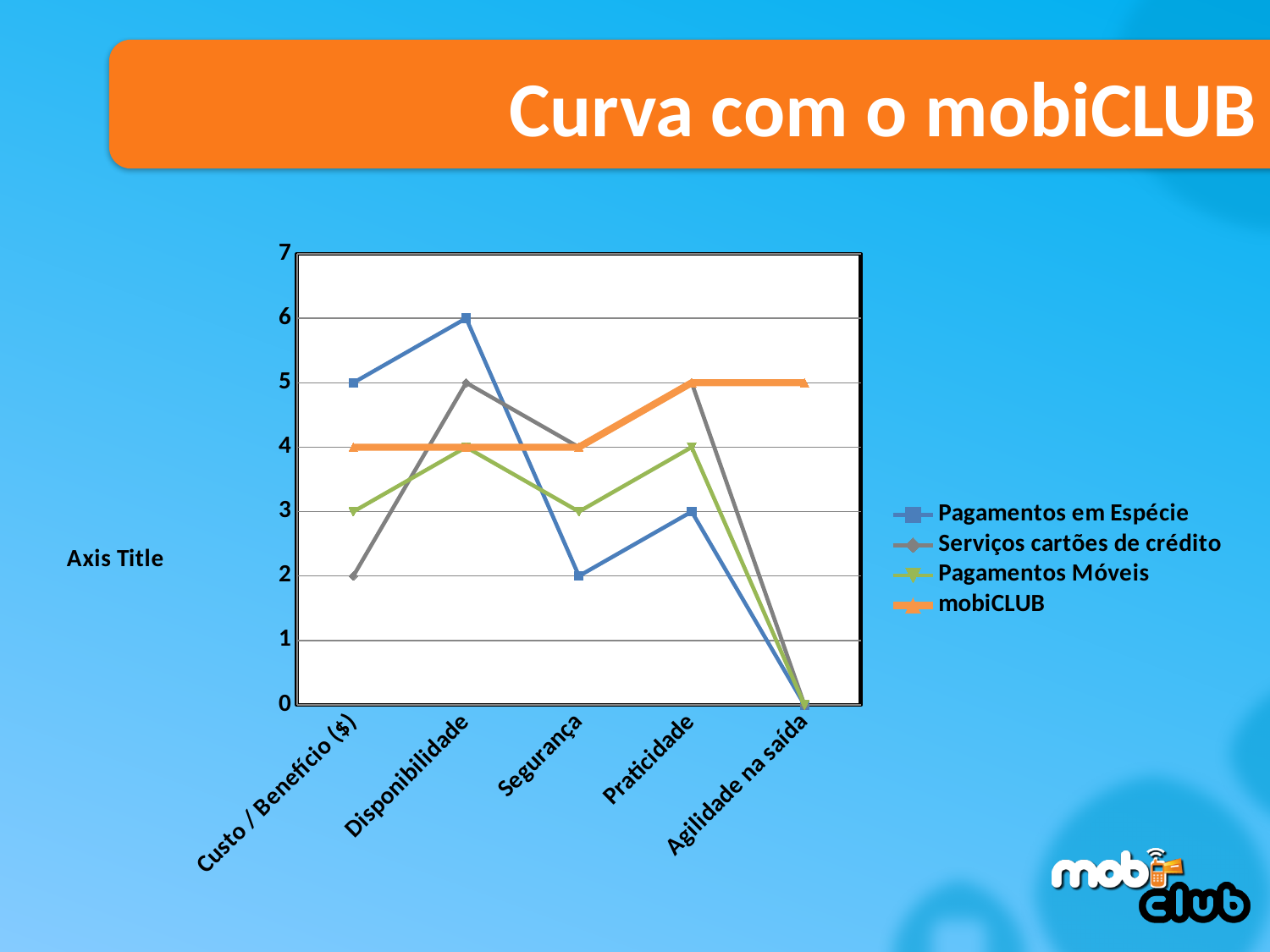
Which series has the highest value for Disponibilidade? Pagamentos em Espécie What is the value of mobiCLUB for Agilidade na saída? 5 What is the difference between Pagamentos em Espécie and Pagamentos Móveis for Custo / Benefício ($)? 2 Does the mobiCLUB series rise or fall from Segurança to Praticidade? rise How many categories are shown on the x axis? 5 What kind of chart is shown on the slide? line chart What is the title of the slide? Curva com o mobiCLUB How many series does the legend list? 4 What is the value of Serviços cartões de crédito for Custo / Benefício ($)? 2 Which series has the lowest value for Segurança? Pagamentos em Espécie What is the value of Pagamentos em Espécie for Disponibilidade? 6 Which is larger for Praticidade: Pagamentos Móveis or mobiCLUB? mobiCLUB